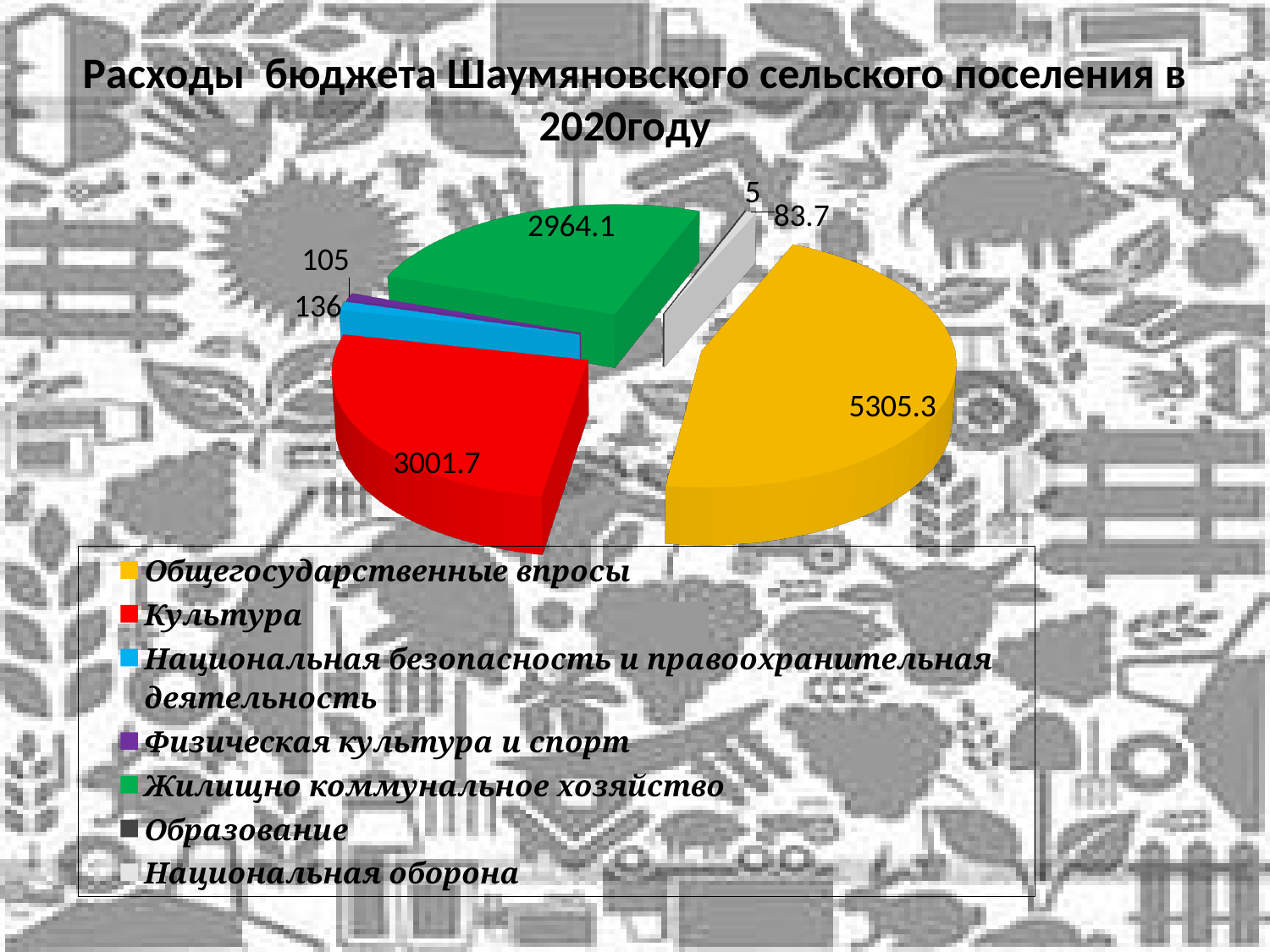
How many categories does the legend list? 7 What kind of chart is shown on the slide? pie chart What colour is the slice for Культура? red What is the value for Общегосударственные впросы? 5305.3 Which category has the smallest value? Образование What is the difference between the values for Культура and Жилищно коммунальное хозяйство? 37.6 What is the value for Национальная оборона? 83.7 What is the value for Культура? 3001.7 What is the value for Жилищно коммунальное хозяйство? 2964.1 What is the value for Национальная безопасность и правоохранительная деятельность? 136 What is the value for Физическая культура и спорт? 105 Which category has the largest value? Общегосударственные впросы